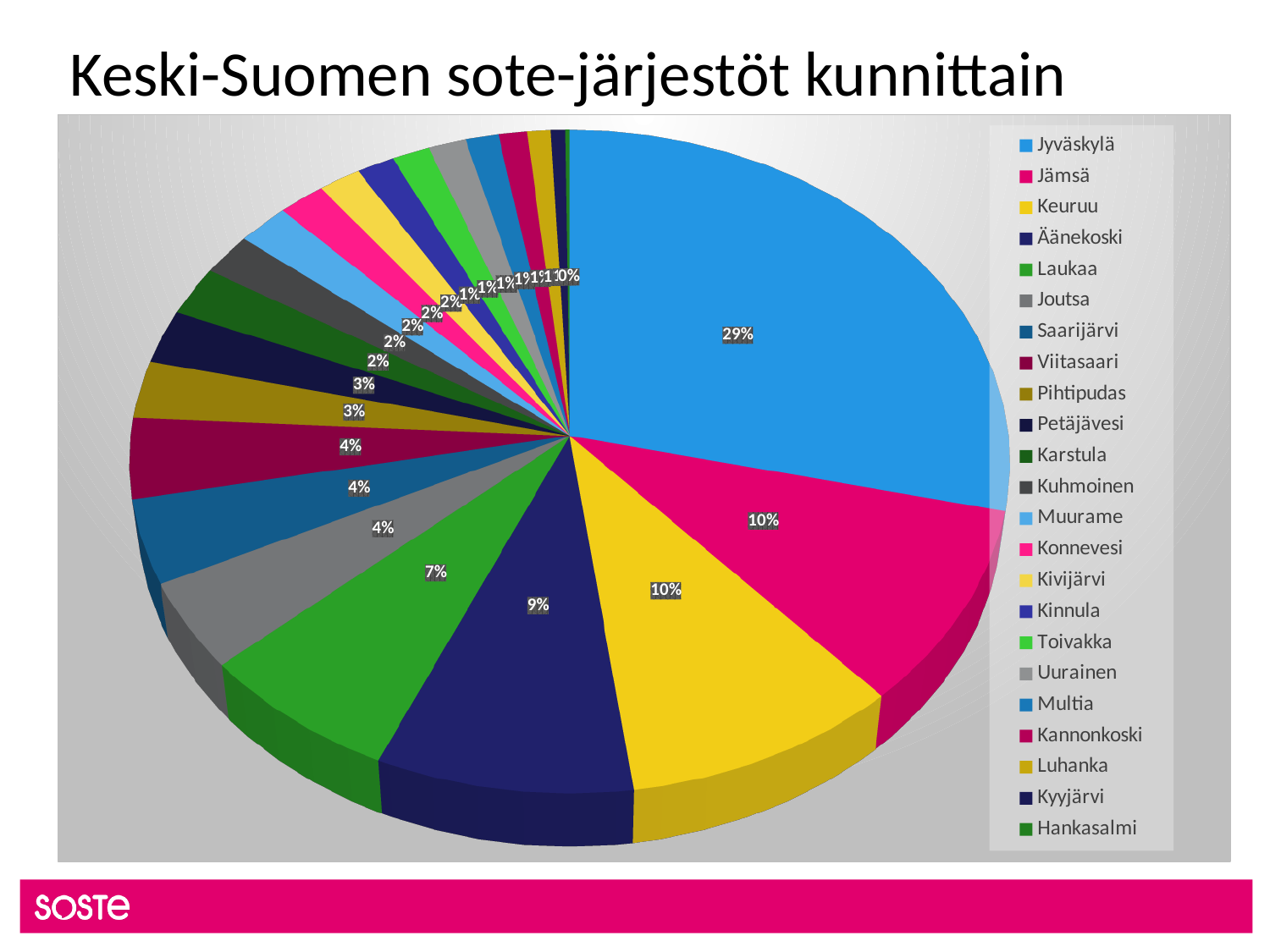
What is the title of the slide? Keski-Suomen sote-järjestöt kunnittain Which has the larger slice, Laukaa or Joutsa? Laukaa What share of the pie does Pihtipudas have? 3% What share of the pie does Jämsä have? 10% Which municipality has the largest slice of the pie? Jyväskylä What share of the pie does Laukaa have? 7% How many municipalities are listed in the legend of the pie chart? 23 What kind of chart is shown on the slide? pie chart How many percentage points larger is Jyväskylä's share than Jämsä's share? 19 What share of the pie does Jyväskylä have? 29% What share of the pie does Äänekoski have? 9% Which municipality is listed first in the legend? Jyväskylä